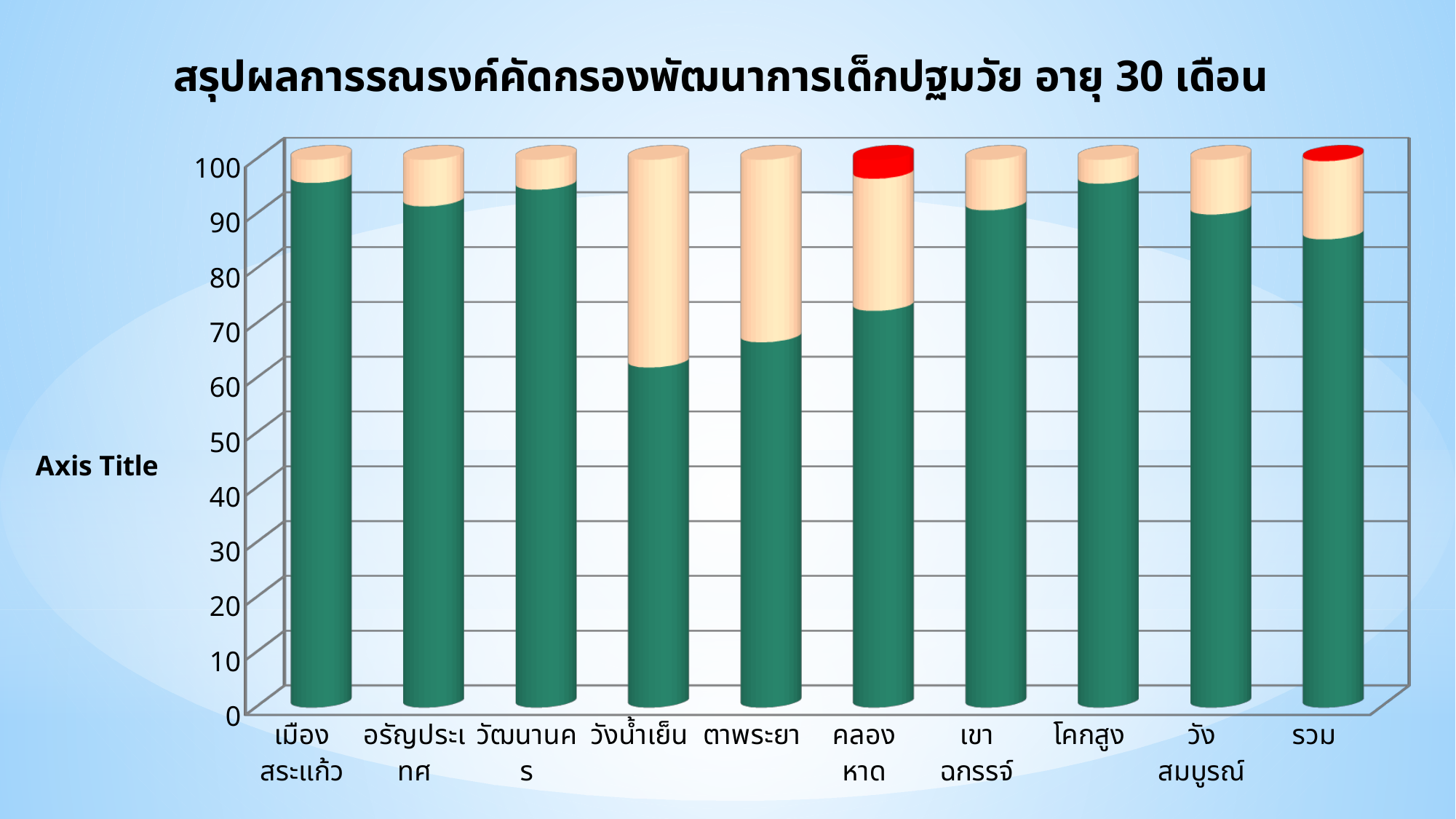
Which has the larger green segment, ตาพระยา or โคกสูง? โคกสูง Is the green segment for รวม greater or less than 80? greater What kind of chart is shown on the slide? bar chart Is the green segment for คลองหาด greater or less than 80? less Is the green segment for ตาพระยา greater or less than 80? less What is the title of the chart? สรุปผลการรณรงค์คัดกรองพัฒนาการเด็กปฐมวัย อายุ 30 เดือน Which category has the lowest green segment in the chart? วังน้ำเย็น How many categories are shown along the x axis of the chart? 10 Which has the larger green segment, วังน้ำเย็น or เขาฉกรรจ์? เขาฉกรรจ์ What is the label shown on the vertical axis of the chart? Axis Title